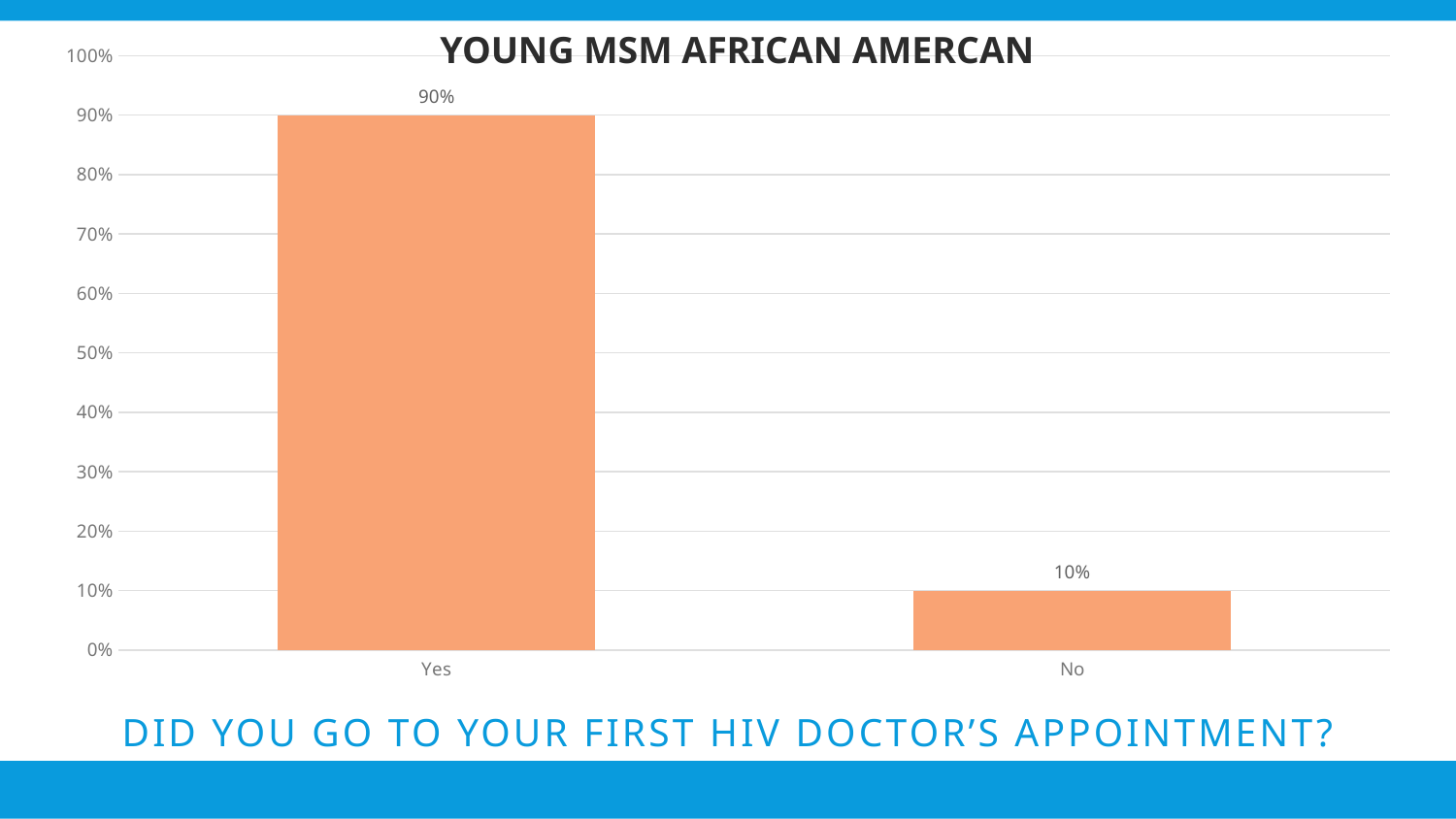
What is the title of the chart? YOUNG MSM AFRICAN AMERCAN Which is larger, the value for Yes or the value for No? Yes Is the value for No greater or less than 20%? less Is the value for Yes greater or less than 50%? greater What is the difference between the values for Yes and No? 80% What is the value for No? 10% What kind of chart is shown on the slide? bar chart Which category has the highest value? Yes Which category has the lowest value? No What question is written below the chart? DID YOU GO TO YOUR FIRST HIV DOCTOR'S APPOINTMENT? How many categories are shown on the x axis? 2 What is the value for Yes? 90%